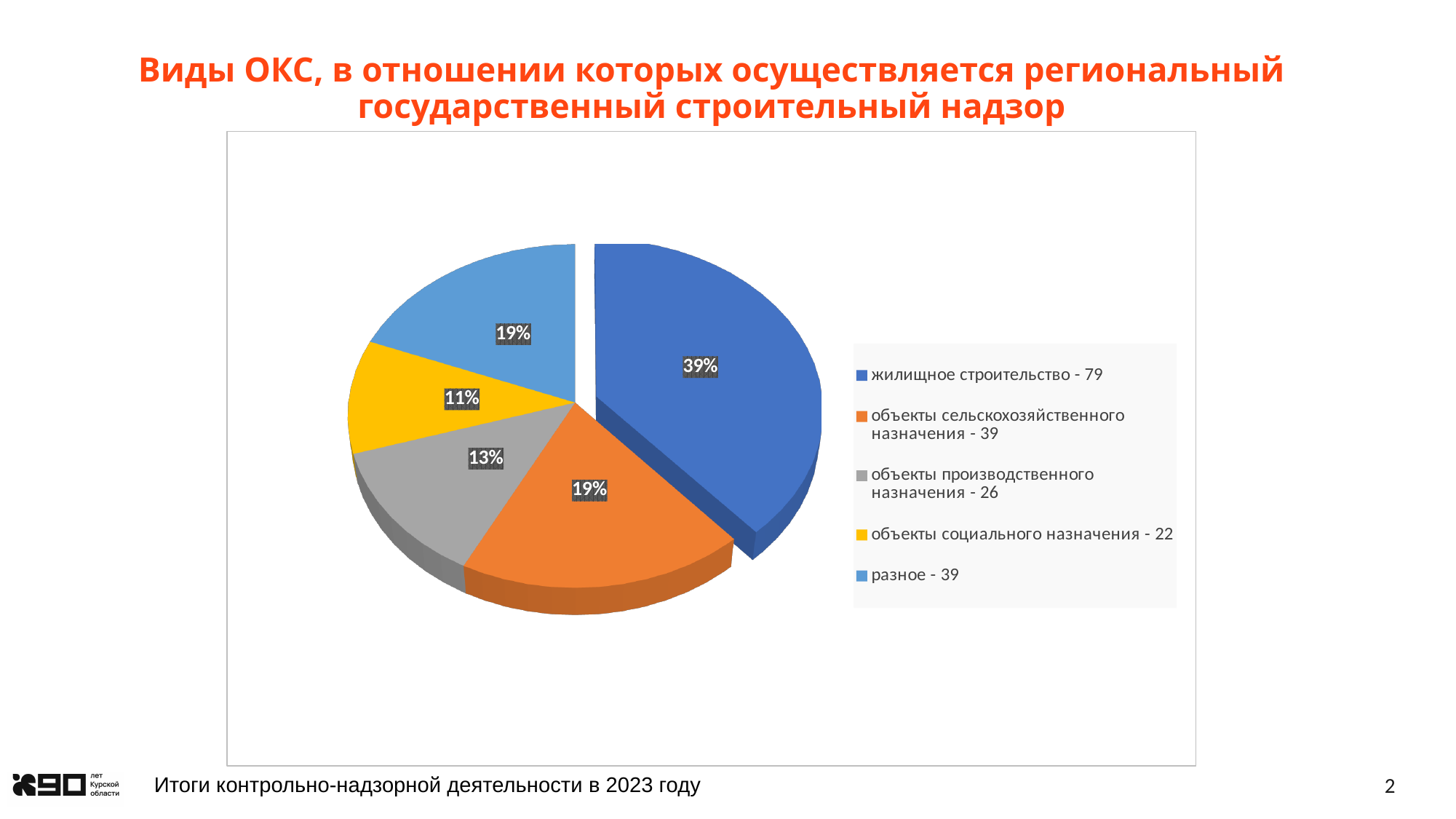
What colour is the slice for "объекты социального назначения"? Yellow What share of the pie does "жилищное строительство" take? 39% Which category has the smallest share of the pie? объекты социального назначения What percentage is shown for "объекты социального назначения"? 11% According to the legend, how many objects are in the category "разное"? 39 What percentage is shown for "объекты производственного назначения"? 13% Which has a larger share: "объекты производственного назначения" or "объекты социального назначения"? объекты производственного назначения Which category has the largest share of the pie? жилищное строительство According to the legend, how many objects are in the category "объекты сельскохозяйственного назначения"? 39 How many slices does the pie chart have? 5 What kind of chart is shown on the slide? Pie chart What is the difference in percentage points between the share of "жилищное строительство" and the share of "объекты социального назначения"? 28